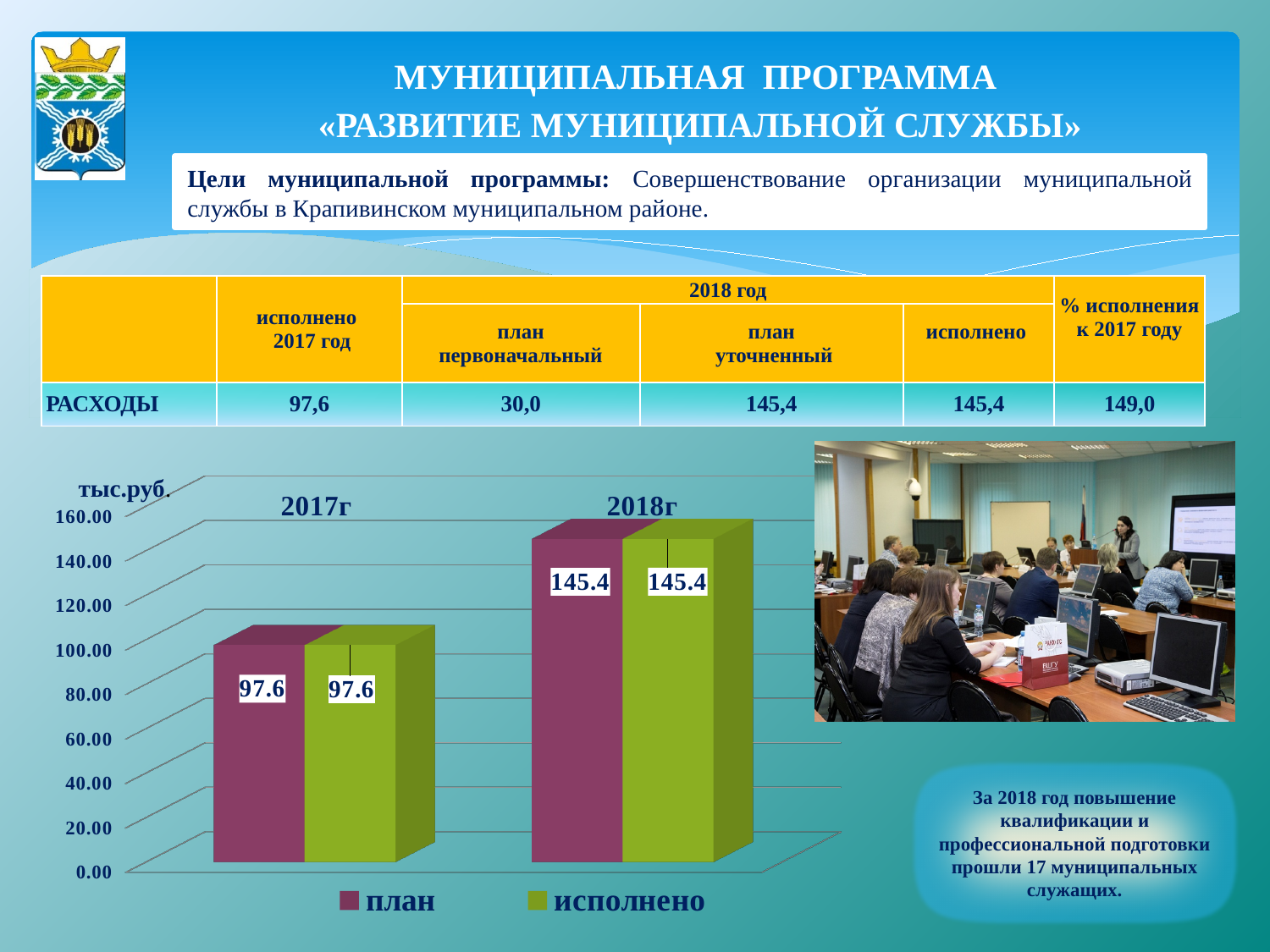
What is the value of план for 2017г? 97.6 What type of chart is shown on the slide? bar chart How many categories are shown on the x axis of the chart? 2 Is the план value for 2018г greater or less than 140.00? greater What is the difference between the исполнено values for 2018г and 2017г? 47.8 What unit is indicated on the vertical axis of the chart? тыс.руб. Which year has the higher план value, 2017г or 2018г? 2018г How many series does the legend list? 2 What is the value of план for 2018г? 145.4 What is the value of исполнено for 2017г? 97.6 Do the исполнено values rise or fall from 2017г to 2018г? rise What is the value of исполнено for 2018г? 145.4